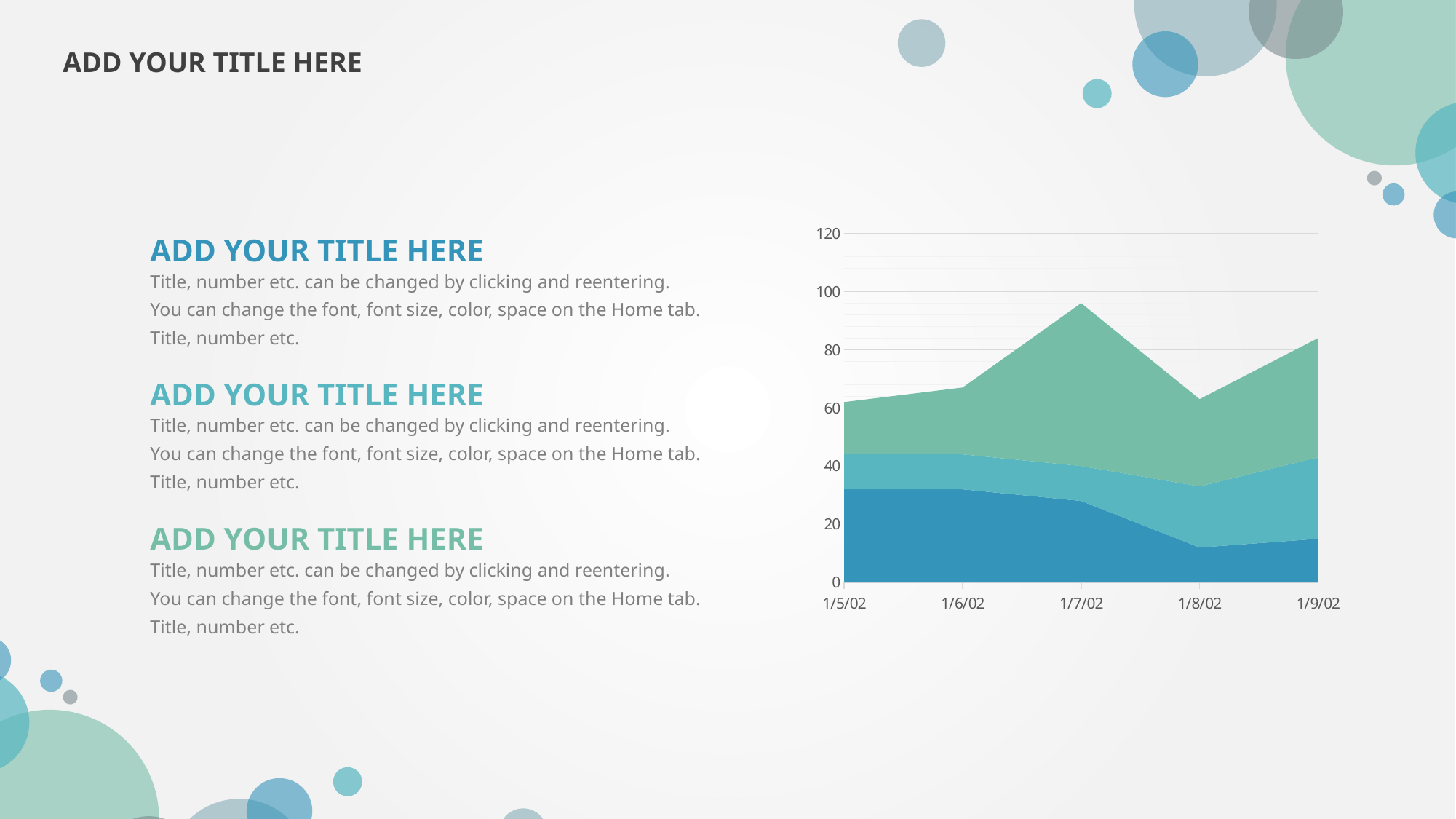
What is the highest value shown on the chart's y axis? 120 Is the value of the bottom (dark blue) series at 1/5/02 greater or less than 20? greater Is the value of the bottom (dark blue) series at 1/8/02 greater or less than 20? less How many stacked series (coloured areas) does the chart show? 3 On which date does the stacked total reach its highest point? 1/7/02 How many dates are shown along the x axis of the chart? 5 Does the bottom (dark blue) series rise or fall from 1/5/02 to 1/8/02? fall Which date has the larger value for the bottom (dark blue) series, 1/5/02 or 1/8/02? 1/5/02 What kind of chart is shown on the slide? Stacked area chart Is the stacked total for 1/7/02 greater or less than 80? greater Which date has the larger stacked total, 1/6/02 or 1/7/02? 1/7/02